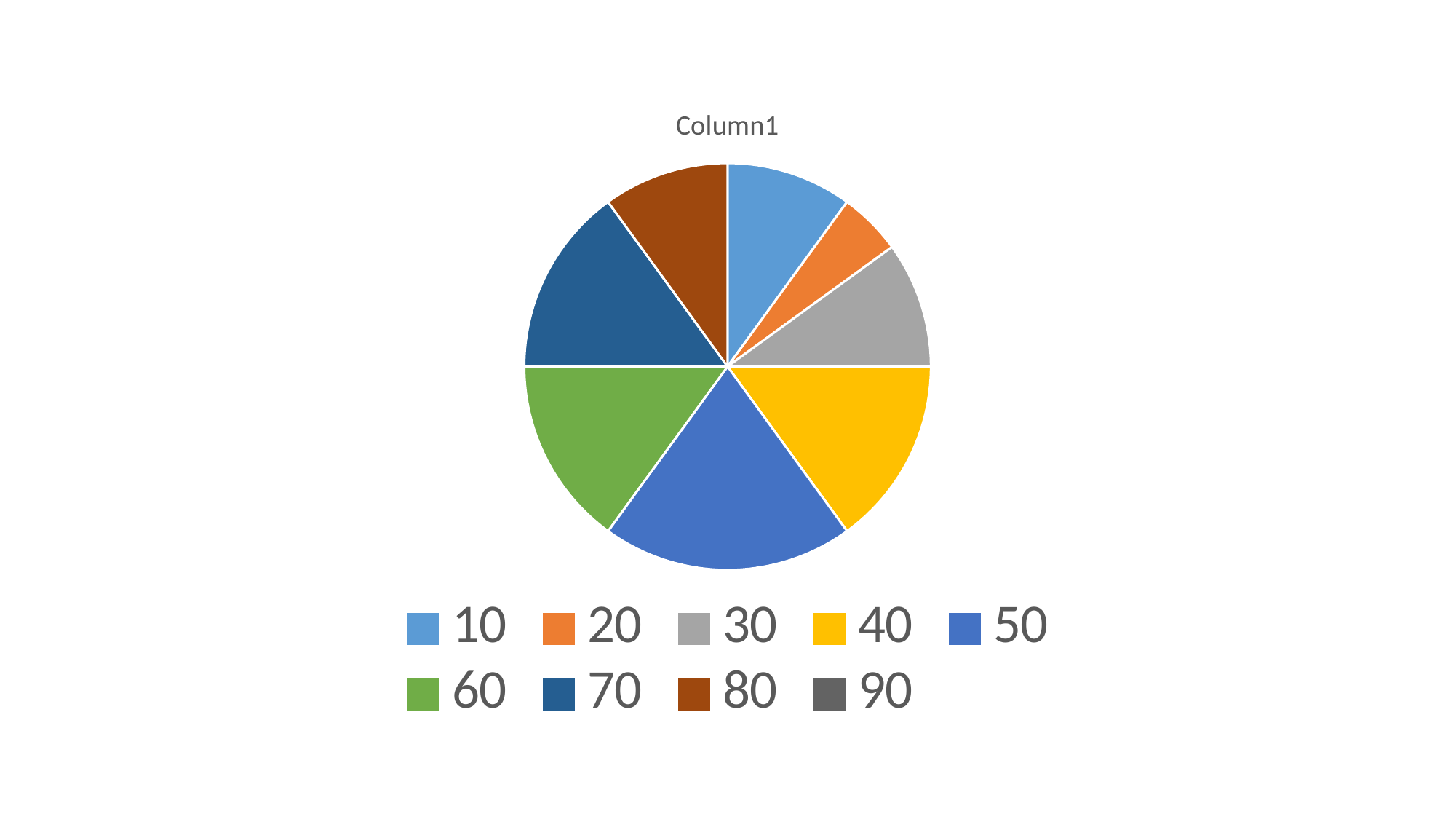
How many entries does the legend list? 9 What colour is the slice for the legend entry 40? yellow Which legend category has the largest slice of the pie? 50 What is the title of the chart? Column1 Which slice is larger, the one for 60 or the one for 20? 60 What kind of chart is shown on the slide? pie chart How many slices are visible in the pie? 8 Which slice is larger, the one for 50 or the one for 20? 50 Which visible slice of the pie is the smallest? 20 Which slice is larger, the one for 40 or the one for 10? 40